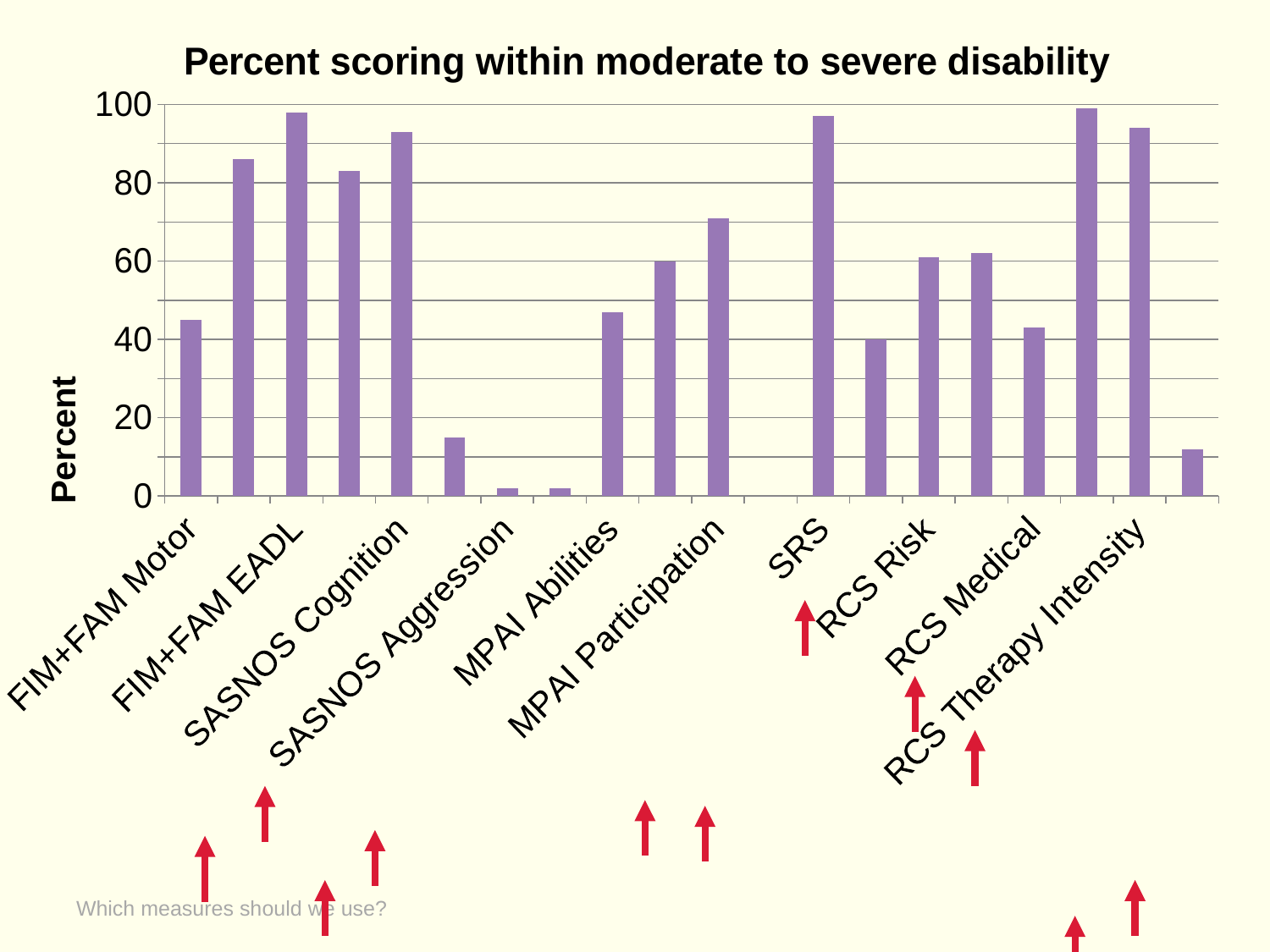
Is the value for FIM+FAM EADL greater or less than 80? greater What is the title of the chart? Percent scoring within moderate to severe disability Is the value for FIM+FAM Motor greater or less than 60? less Is the value for SRS greater or less than 80? greater What is the label on the vertical axis of the chart? Percent What kind of chart is shown on the slide? bar chart Which is larger, the value for RCS Therapy Intensity or the value for RCS Medical? RCS Therapy Intensity Which is larger, the value for SASNOS Cognition or the value for SASNOS Aggression? SASNOS Cognition Which is larger, the value for FIM+FAM EADL or the value for FIM+FAM Motor? FIM+FAM EADL